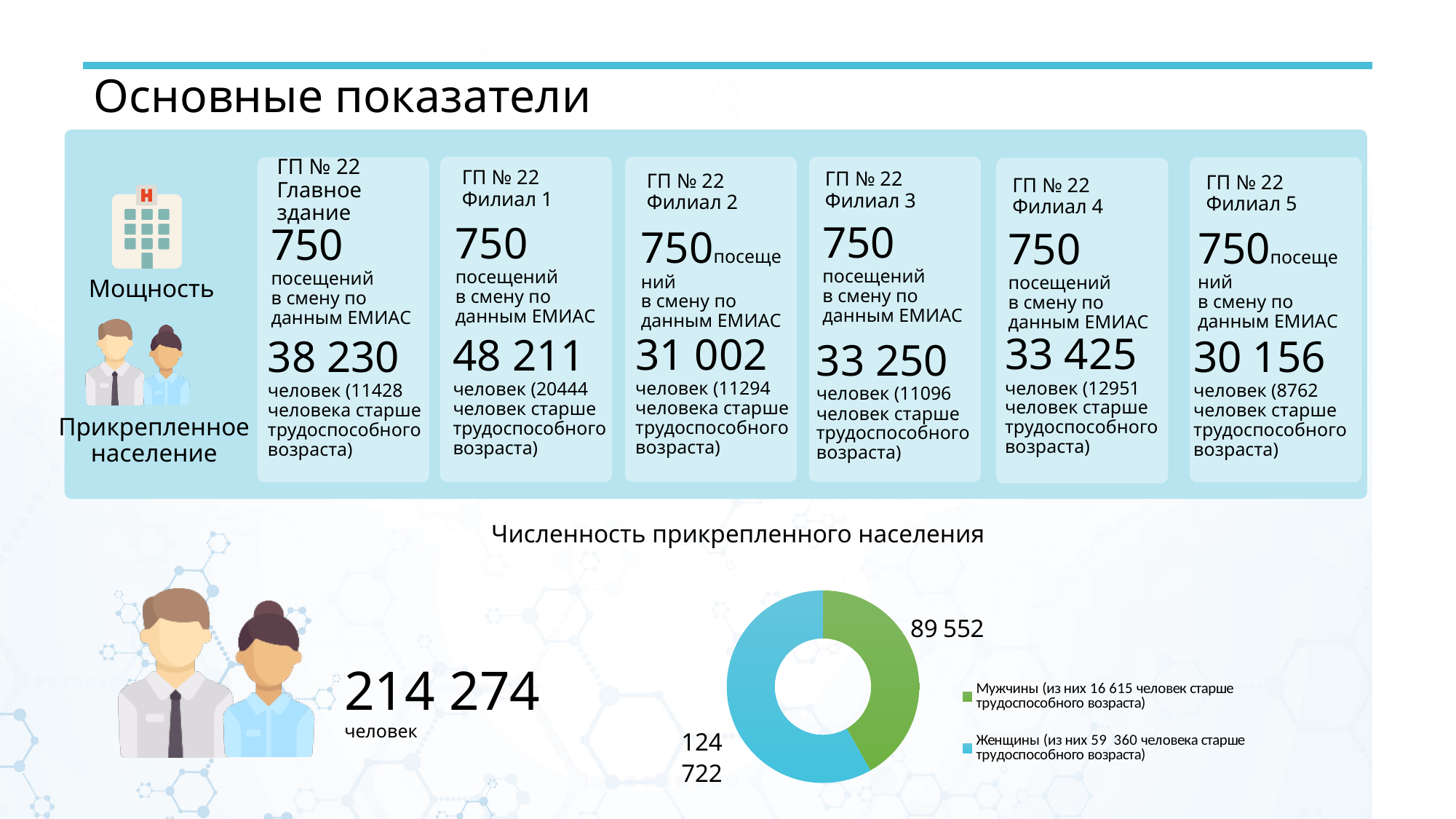
What share of the total does the Женщины slice represent in the donut chart? 58.2% In the donut chart, which is larger: Мужчины or Женщины? Женщины How many entries does the legend of the donut chart list? 2 What is the difference between the Женщины and Мужчины values in the donut chart? 35 170 What value is shown for Мужчины in the donut chart? 89 552 How many slices does the donut chart have? 2 What is the title of the chart on the slide? Численность прикрепленного населения What kind of chart is shown under the heading "Численность прикрепленного населения"? Donut (pie) chart What value is shown for Женщины in the donut chart? 124 722 Which colour represents Мужчины in the donut chart? Green Which slice of the donut chart is the smallest? Мужчины Which slice of the donut chart is the largest? Женщины